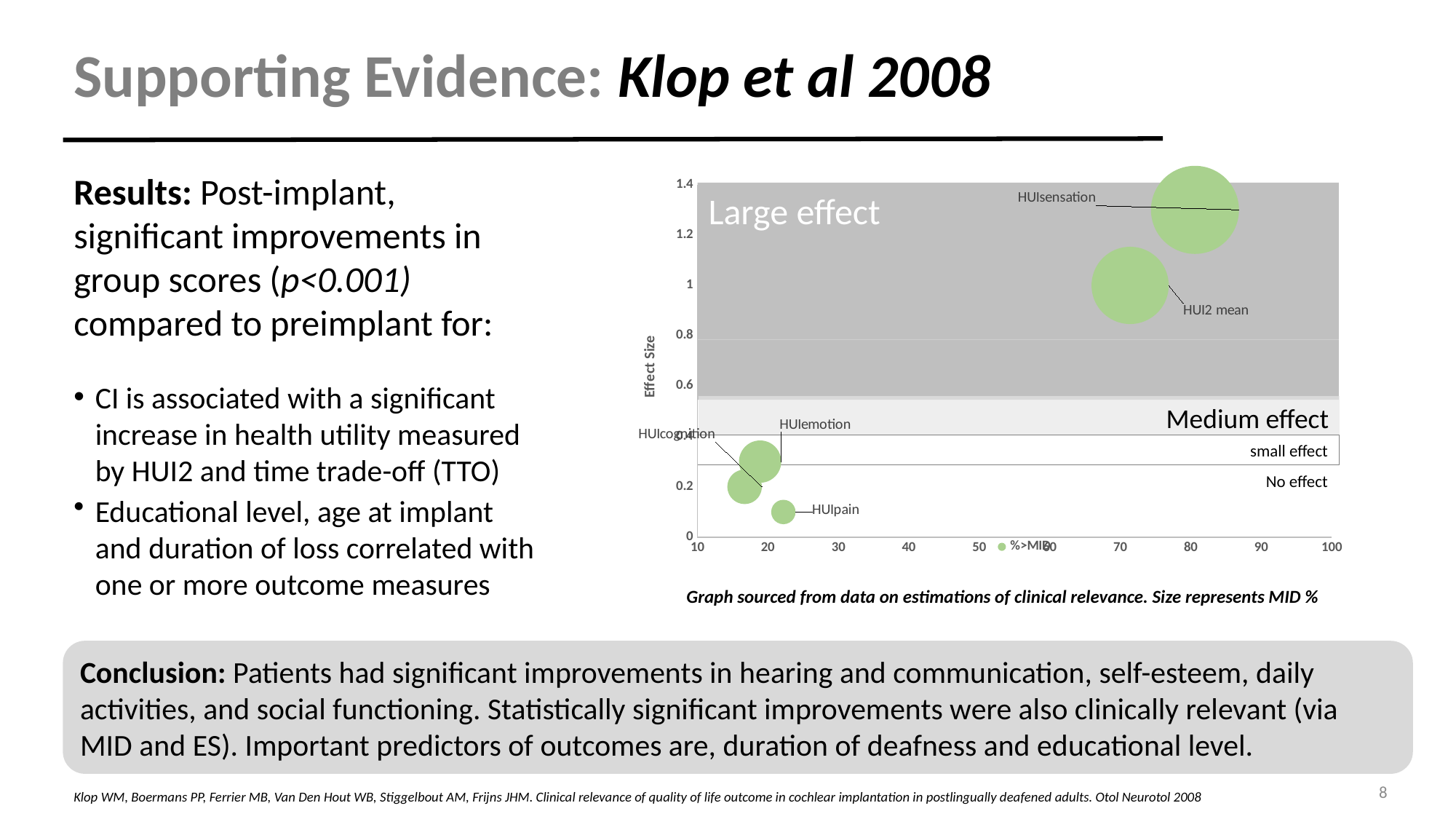
What kind of chart is shown on the slide? bubble chart Is the effect size for HUIpain greater or less than 0.2? less Is the effect size for HUI2 mean greater or less than 0.8? greater Which shaded effect region does the HUIsensation bubble fall in? Large effect Which has the larger effect size, HUIsensation or HUI2 mean? HUIsensation How many series does the chart legend list? 1 Which labelled bubble has the highest effect size? HUIsensation Which labelled bubble has the lowest effect size? HUIpain Is the effect size for HUIsensation greater or less than 1.2? greater How many labelled bubbles are plotted on the chart? 5 What is the title of the vertical axis of the chart? Effect Size